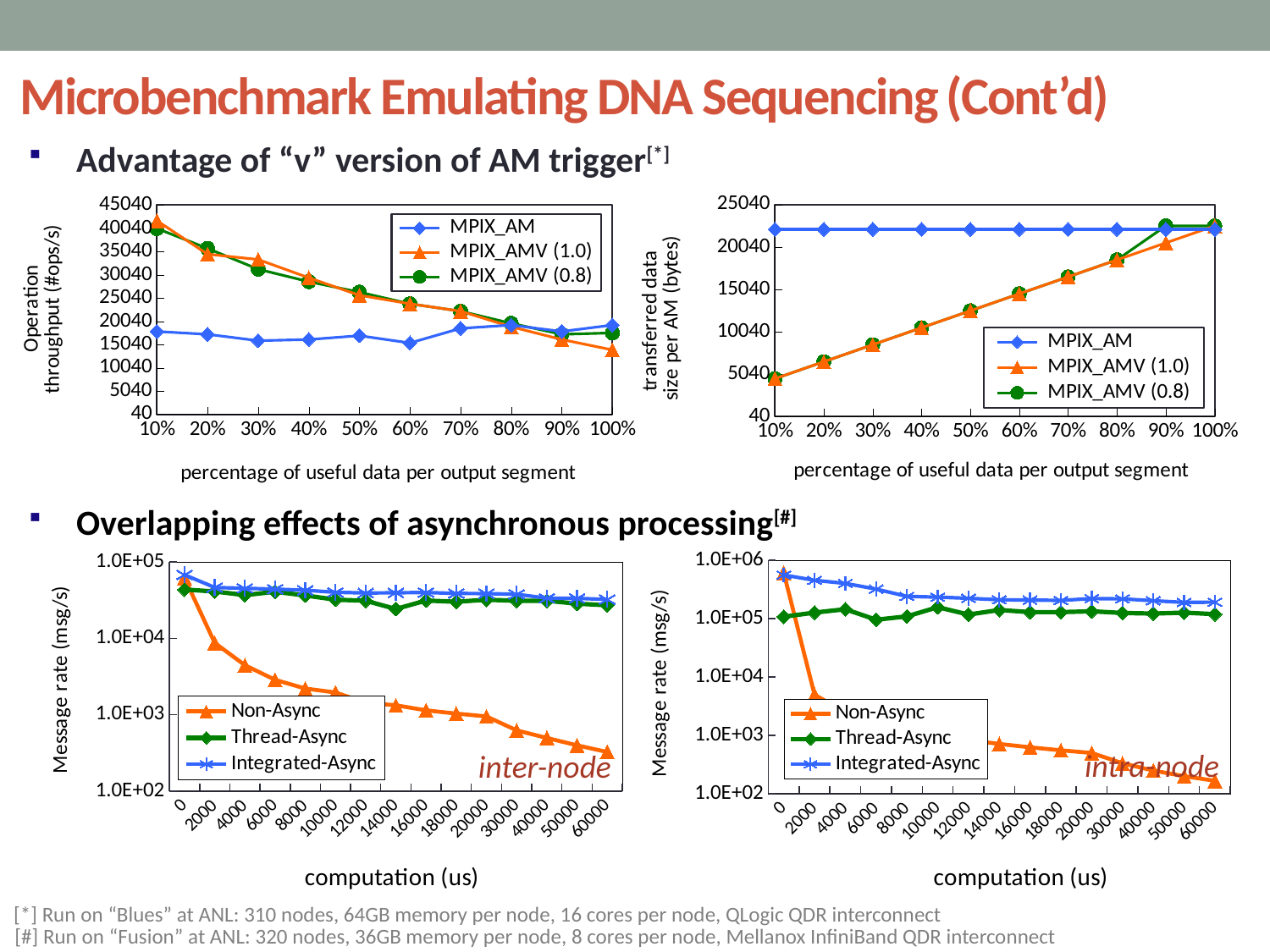
In the top-right chart (transferred data size per AM), does the MPIX_AMV (1.0) series rise or fall as the percentage of useful data increases? rise In the top-left chart (Operation throughput), is the value for MPIX_AMV (1.0) at 10% greater or less than 40040? greater In the top-left chart (Operation throughput), how many series does the legend list? 3 In the top-right chart (transferred data size per AM), which is larger at 10%: MPIX_AM or MPIX_AMV (1.0)? MPIX_AM In the bottom-right chart (intra-node), which is larger at 60000: Integrated-Async or Non-Async? Integrated-Async In the bottom-left chart (inter-node), does the Non-Async series rise or fall as computation increases? fall In the top-left chart (Operation throughput), does the MPIX_AMV (1.0) series rise or fall as the percentage of useful data increases? fall In the top-left chart (Operation throughput), what kind of chart is it? line chart In the top-left chart (Operation throughput), is the value for MPIX_AM at 10% greater or less than 20040? less In the bottom-left chart (inter-node), is the value for Non-Async at 60000 greater or less than 1.0E+03? less In the top-right chart (transferred data size per AM), how many percentage categories are shown on the x axis? 10